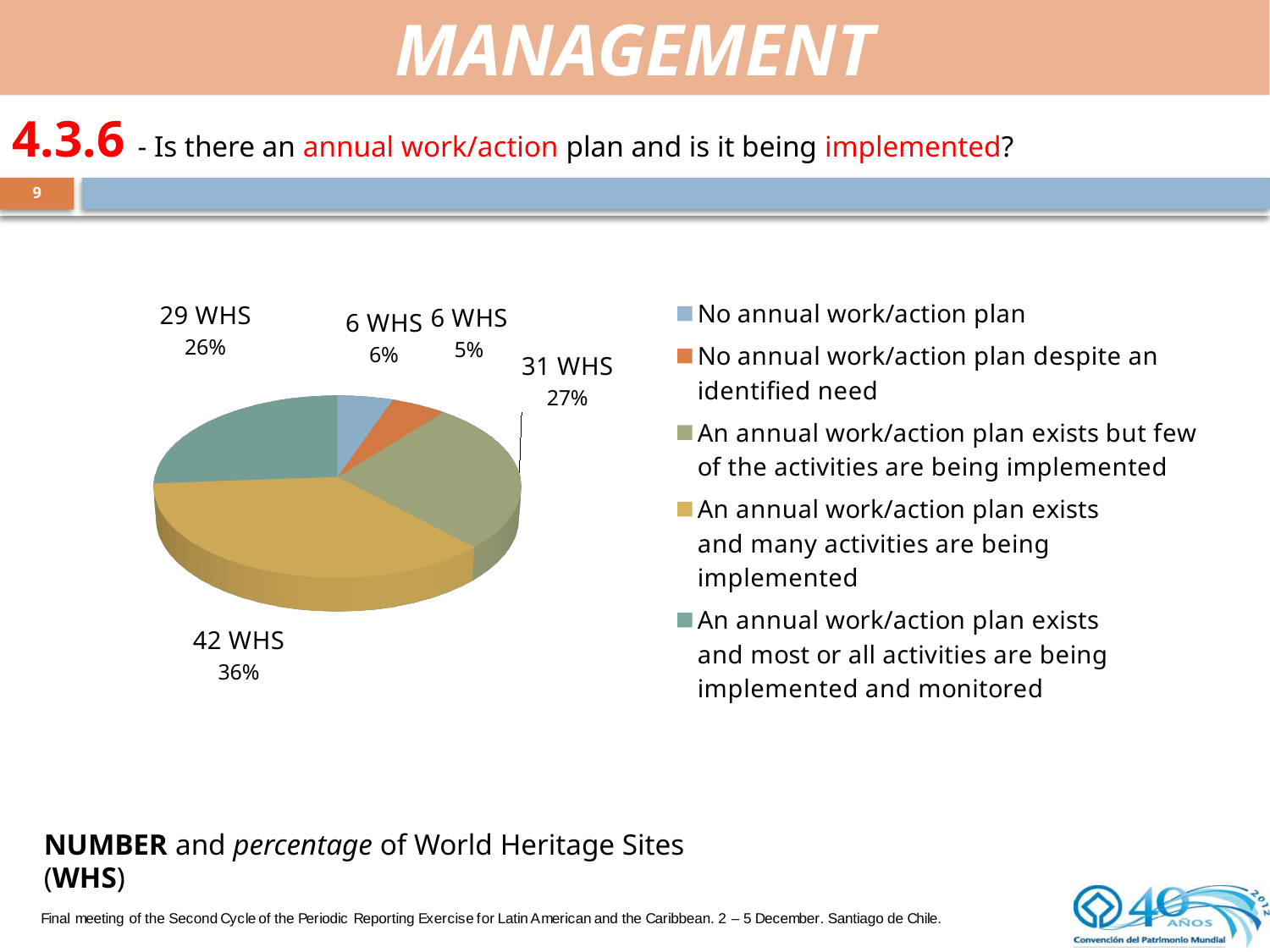
What percentage of sites have an annual work/action plan that exists but few of the activities are being implemented? 27% How many World Heritage Sites have an annual work/action plan with many activities being implemented? 42 WHS How many categories does the legend of the pie chart list? 5 How many World Heritage Sites have an annual work/action plan that exists but few of the activities are being implemented? 31 WHS What percentage of sites have an annual work/action plan with most or all activities being implemented and monitored? 26% What is the total number of World Heritage Sites represented in the pie chart? 114 WHS What kind of chart is shown on the slide? pie chart Which is larger: the share of sites with a plan where few activities are implemented, or the share with a plan where most or all activities are implemented and monitored? few activities are being implemented (27%) What colour is the slice for 'No annual work/action plan despite an identified need'? orange What is the difference in number of sites between the 'many activities being implemented' category and the 'most or all activities being implemented and monitored' category? 13 WHS What does the caption below the chart say the chart shows? NUMBER and percentage of World Heritage Sites (WHS) Which category has the largest share of the pie? An annual work/action plan exists and many activities are being implemented